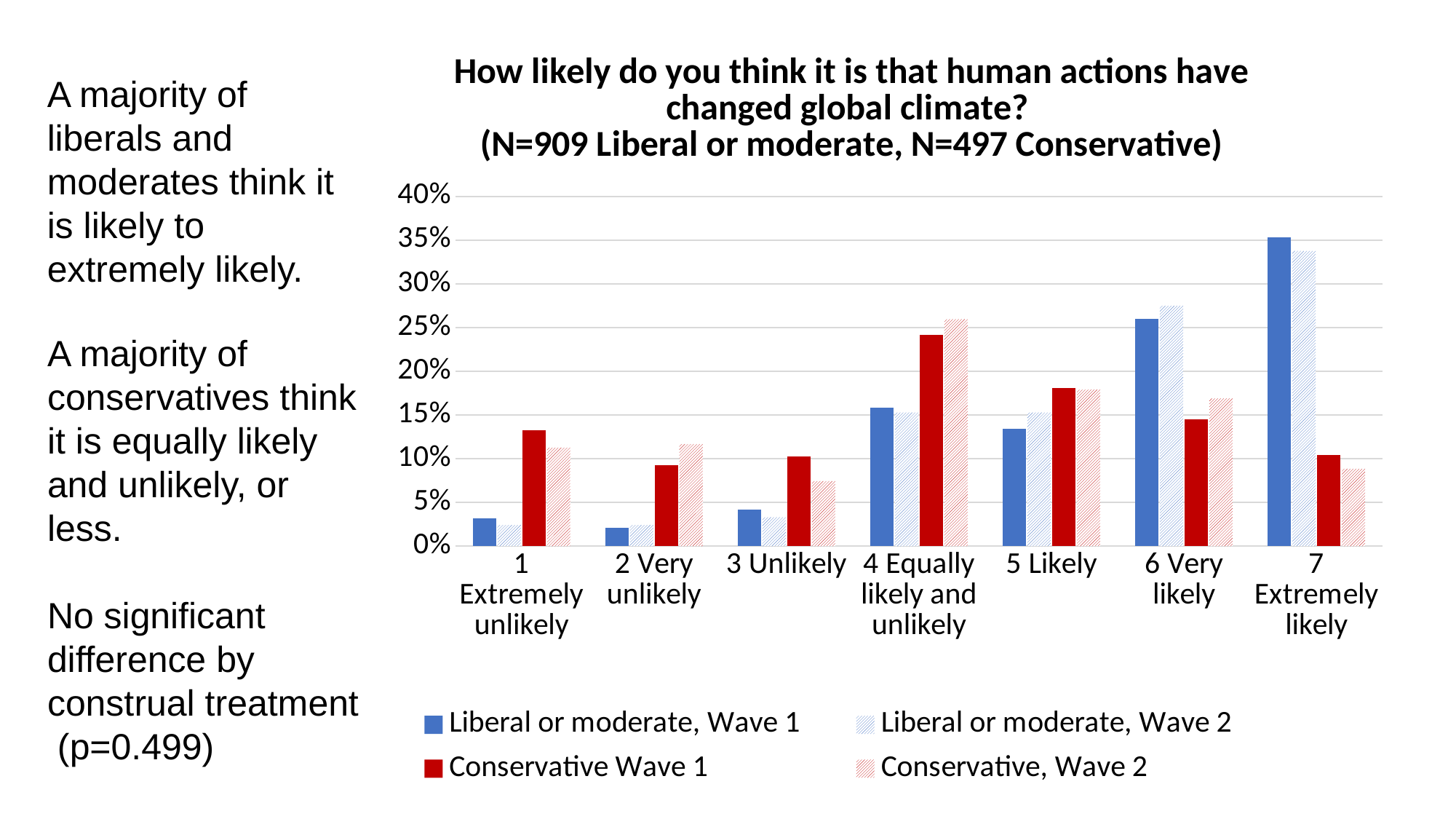
For '7 Extremely likely', which is larger: the 'Liberal or moderate, Wave 1' value or the 'Conservative Wave 1' value? Liberal or moderate, Wave 1 According to the chart title, how many Conservative respondents were surveyed? N=497 For the 'Liberal or moderate, Wave 1' series, which response category has the highest value? 7 Extremely likely Is the 'Conservative Wave 1' value for '4 Equally likely and unlikely' greater or less than 20%? greater For the 'Liberal or moderate, Wave 1' series, which response category has the lowest value? 2 Very unlikely What kind of chart is shown on the slide? bar chart How many response categories are shown along the x axis of the chart? 7 Is the 'Conservative Wave 1' value for '7 Extremely likely' greater or less than 15%? less For '1 Extremely unlikely', which is larger: the 'Conservative Wave 1' value or the 'Liberal or moderate, Wave 1' value? Conservative Wave 1 For the 'Conservative Wave 1' series, which response category has the highest value? 4 Equally likely and unlikely Is the 'Liberal or moderate, Wave 1' value for '7 Extremely likely' greater or less than 30%? greater How many series does the chart's legend list? 4